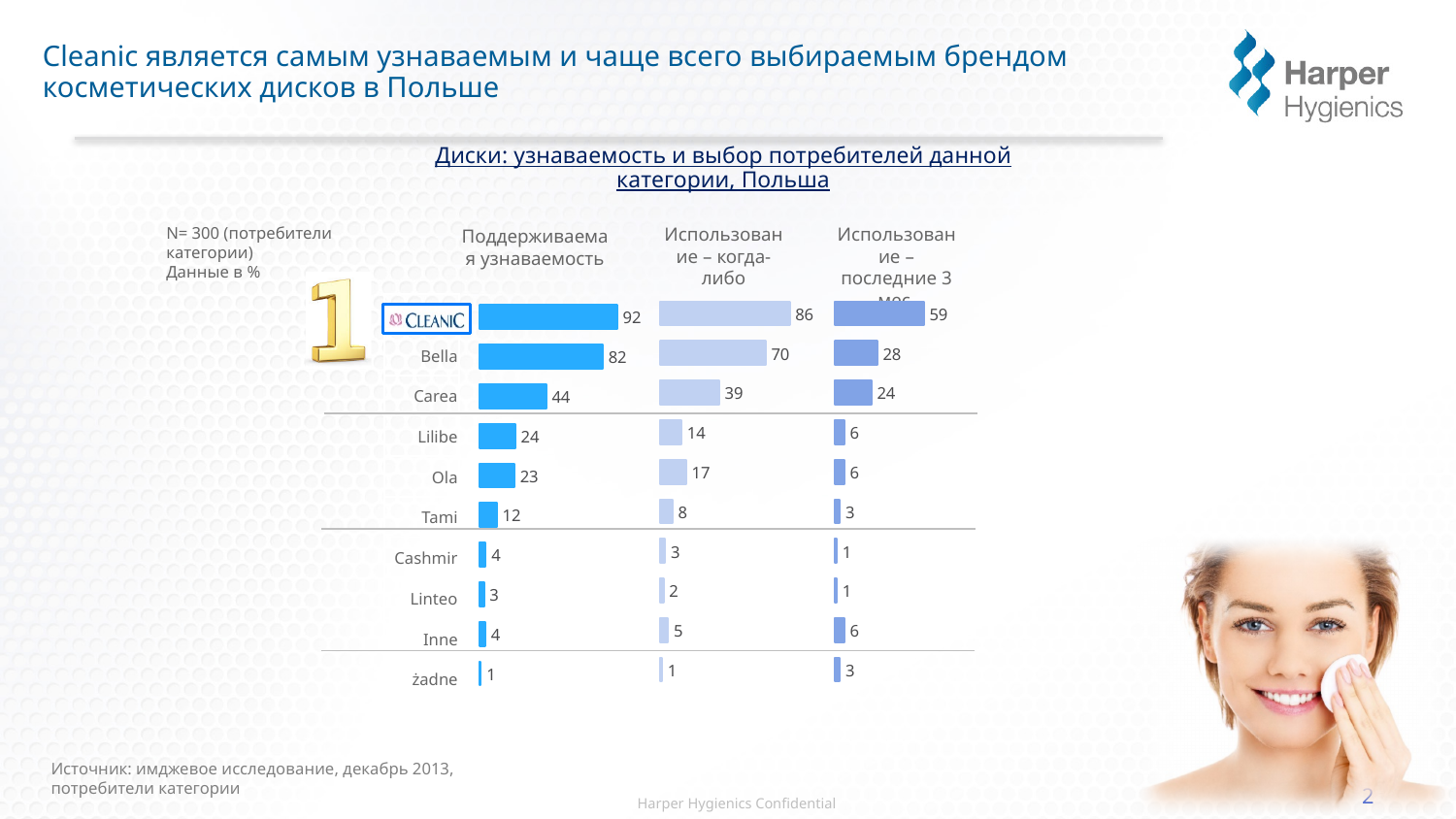
In the 'Использование – последние 3 мес' chart, what is the difference between Cleanic and Bella? 31 In the 'Использование – когда-либо' chart, which is larger, Lilibe or Ola? Ola In the 'Поддерживаемая узнаваемость' chart, what is the difference between Cleanic and Bella? 10 In the 'Поддерживаемая узнаваемость' chart, which brand has the highest value? Cleanic In the 'Использование – когда-либо' chart, what is the value for Carea? 39 What is the sample size (N) stated on the slide? 300 In the 'Использование – когда-либо' chart, which category has the lowest value? żadne In the 'Поддерживаемая узнаваемость' chart, what is the value for Bella? 82 How many brand categories are listed in the charts? 10 In the 'Использование – последние 3 мес' chart, what is the value for Cleanic? 59 In the 'Поддерживаемая узнаваемость' chart, which is larger, Carea or Lilibe? Carea What type of chart is used on the slide? Bar chart